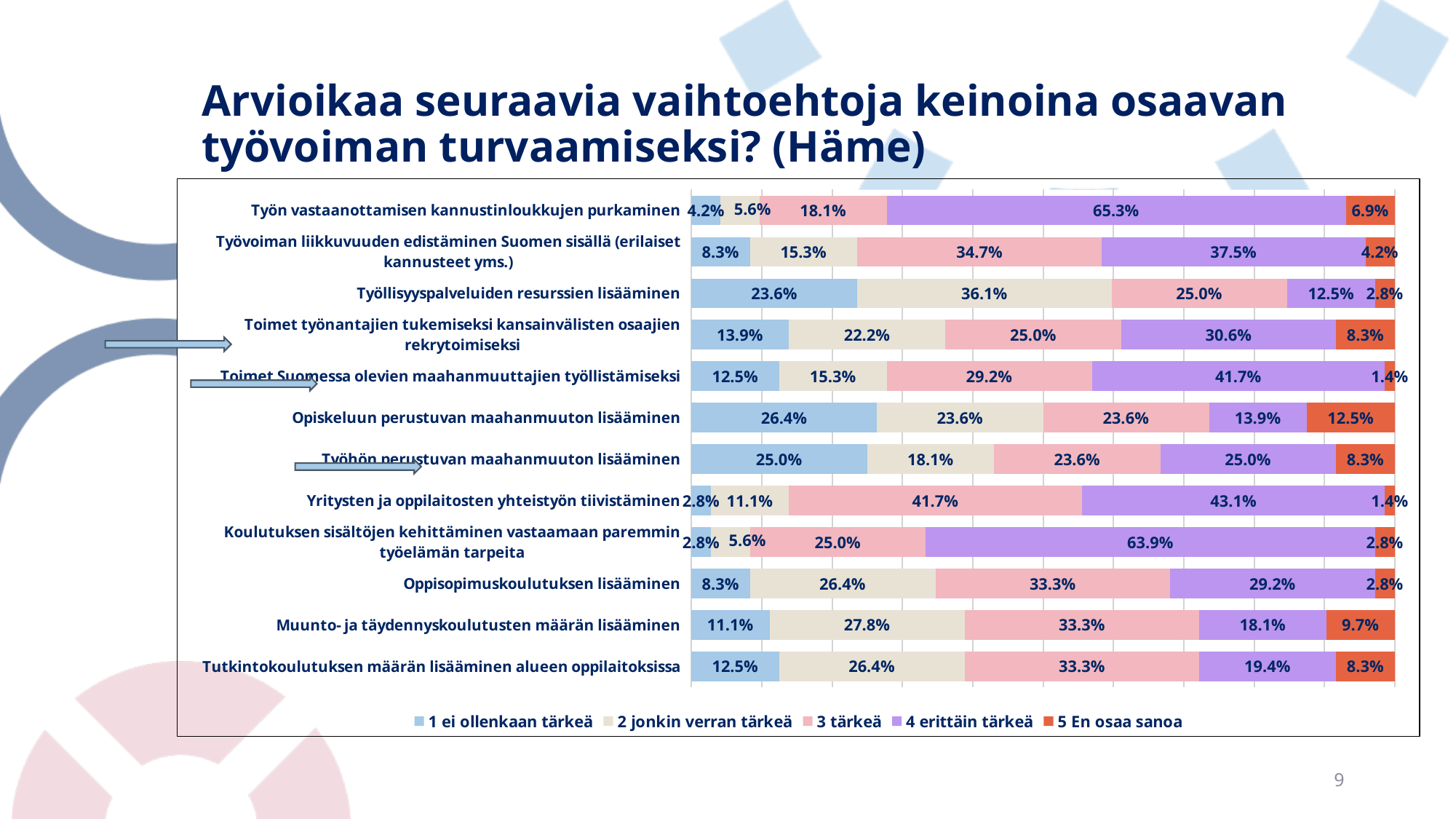
Which category has the highest '4 erittäin tärkeä' share? Työn vastaanottamisen kannustinloukkujen purkaminen What is the difference in the '4 erittäin tärkeä' share between 'Työn vastaanottamisen kannustinloukkujen purkaminen' and 'Koulutuksen sisältöjen kehittäminen vastaamaan paremmin työelämän tarpeita'? 1.4 percentage points What is the '5 En osaa sanoa' value for 'Muunto- ja täydennyskoulutusten määrän lisääminen'? 9.7% What type of chart is shown on the slide? Stacked bar chart Which has a larger '2 jonkin verran tärkeä' share: 'Työllisyyspalveluiden resurssien lisääminen' or 'Oppisopimuskoulutuksen lisääminen'? Työllisyyspalveluiden resurssien lisääminen Which category has the highest '1 ei ollenkaan tärkeä' share? Opiskeluun perustuvan maahanmuuton lisääminen What is the '1 ei ollenkaan tärkeä' value for 'Työllisyyspalveluiden resurssien lisääminen'? 23.6% What is the '3 tärkeä' value for 'Yritysten ja oppilaitosten yhteistyön tiivistäminen'? 41.7% What percentage of respondents rated 'Työn vastaanottamisen kannustinloukkujen purkaminen' as '4 erittäin tärkeä'? 65.3% How many series does the legend list? 5 How many categories (rows) are shown in the chart? 12 Which category has the lowest '4 erittäin tärkeä' share? Työllisyyspalveluiden resurssien lisääminen